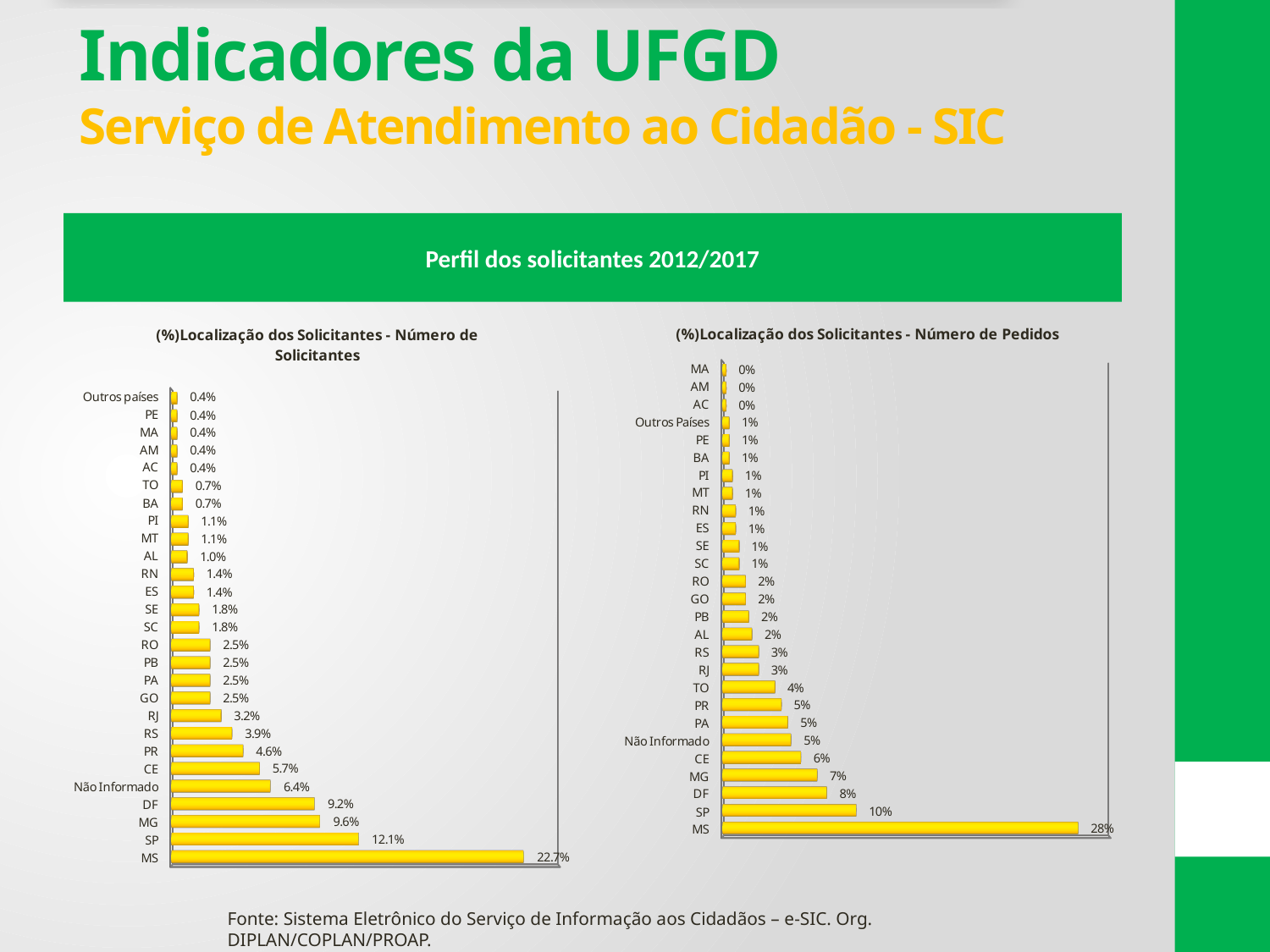
In the chart titled "(%)Localização dos Solicitantes - Número de Solicitantes", what is the value for MS? 22.7% In the chart titled "(%)Localização dos Solicitantes - Número de Solicitantes", what is the difference between the values for SP and MG? 2.5% What colour are the bars in the chart titled "(%)Localização dos Solicitantes - Número de Solicitantes"? Yellow In the chart titled "(%)Localização dos Solicitantes - Número de Pedidos", which is larger, the value for CE or the value for TO? CE In the chart titled "(%)Localização dos Solicitantes - Número de Pedidos", what is the value for SP? 10% In the chart titled "(%)Localização dos Solicitantes - Número de Solicitantes", which category has the highest value? MS In the chart titled "(%)Localização dos Solicitantes - Número de Pedidos", what is the difference between the values for DF and MG? 1% In the chart titled "(%)Localização dos Solicitantes - Número de Solicitantes", how many categories are plotted? 27 In the chart titled "(%)Localização dos Solicitantes - Número de Solicitantes", what is the value for DF? 9.2% What kind of chart is the chart titled "(%)Localização dos Solicitantes - Número de Pedidos"? Bar chart In the chart titled "(%)Localização dos Solicitantes - Número de Solicitantes", which is larger, the value for CE or the value for PR? CE In the chart titled "(%)Localização dos Solicitantes - Número de Pedidos", what is the value for MS? 28%